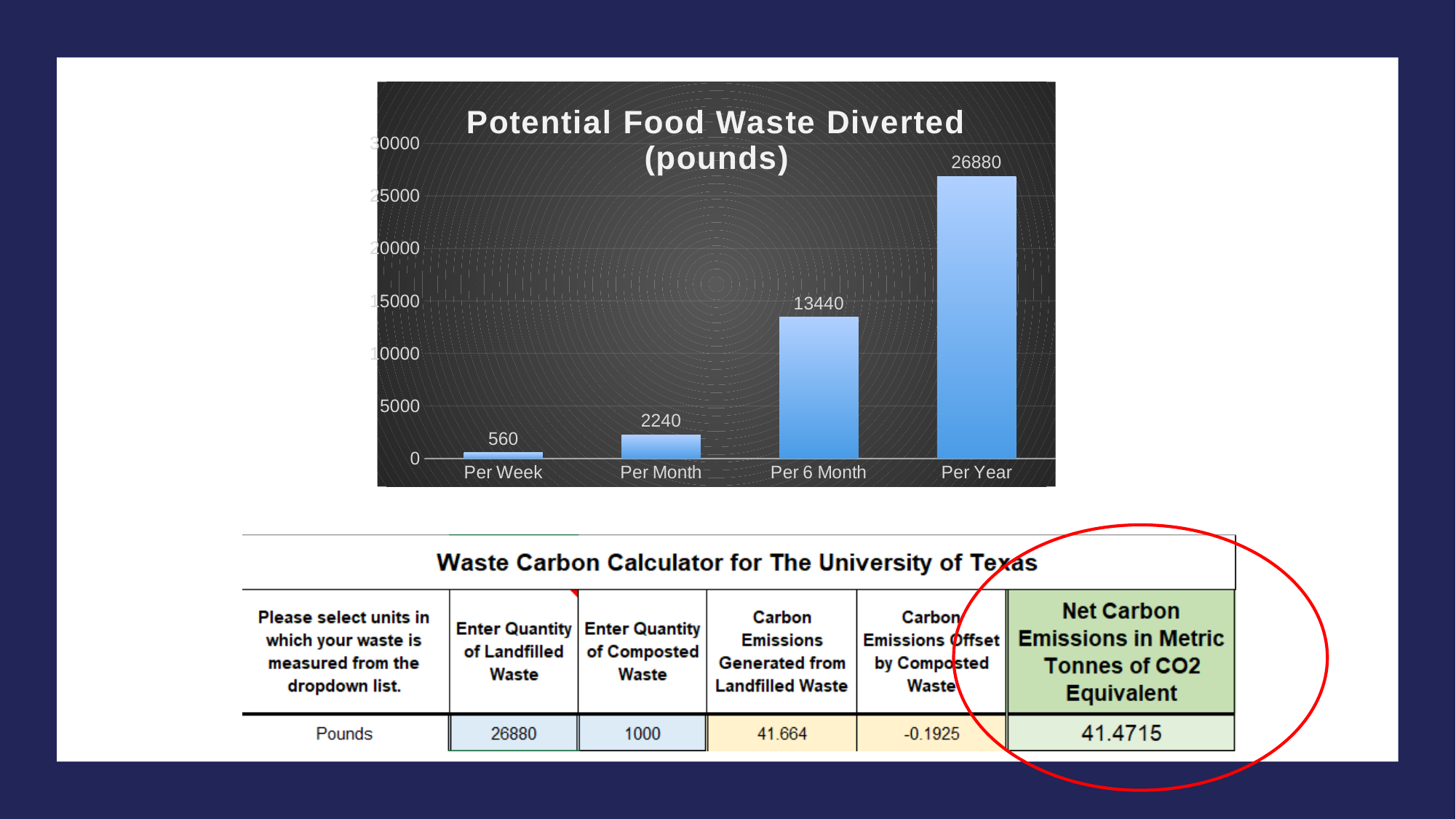
What kind of chart is the Potential Food Waste Diverted chart? bar chart What is the value for Per 6 Month in the Potential Food Waste Diverted chart? 13440 Which category has the highest value in the Potential Food Waste Diverted chart? Per Year How many categories are shown in the Potential Food Waste Diverted chart? 4 What is the value for Per Month in the Potential Food Waste Diverted chart? 2240 What is the value for Per Week in the Potential Food Waste Diverted chart? 560 Is the value for Per 6 Month in the Potential Food Waste Diverted chart greater or less than 10000? greater What is the difference between the Per Year and Per 6 Month values in the Potential Food Waste Diverted chart? 13440 What is the value for Per Year in the Potential Food Waste Diverted chart? 26880 Which category has the lowest value in the Potential Food Waste Diverted chart? Per Week Which is larger in the Potential Food Waste Diverted chart, Per Month or Per 6 Month? Per 6 Month Do the values in the Potential Food Waste Diverted chart rise or fall from Per Week to Per Year? rise